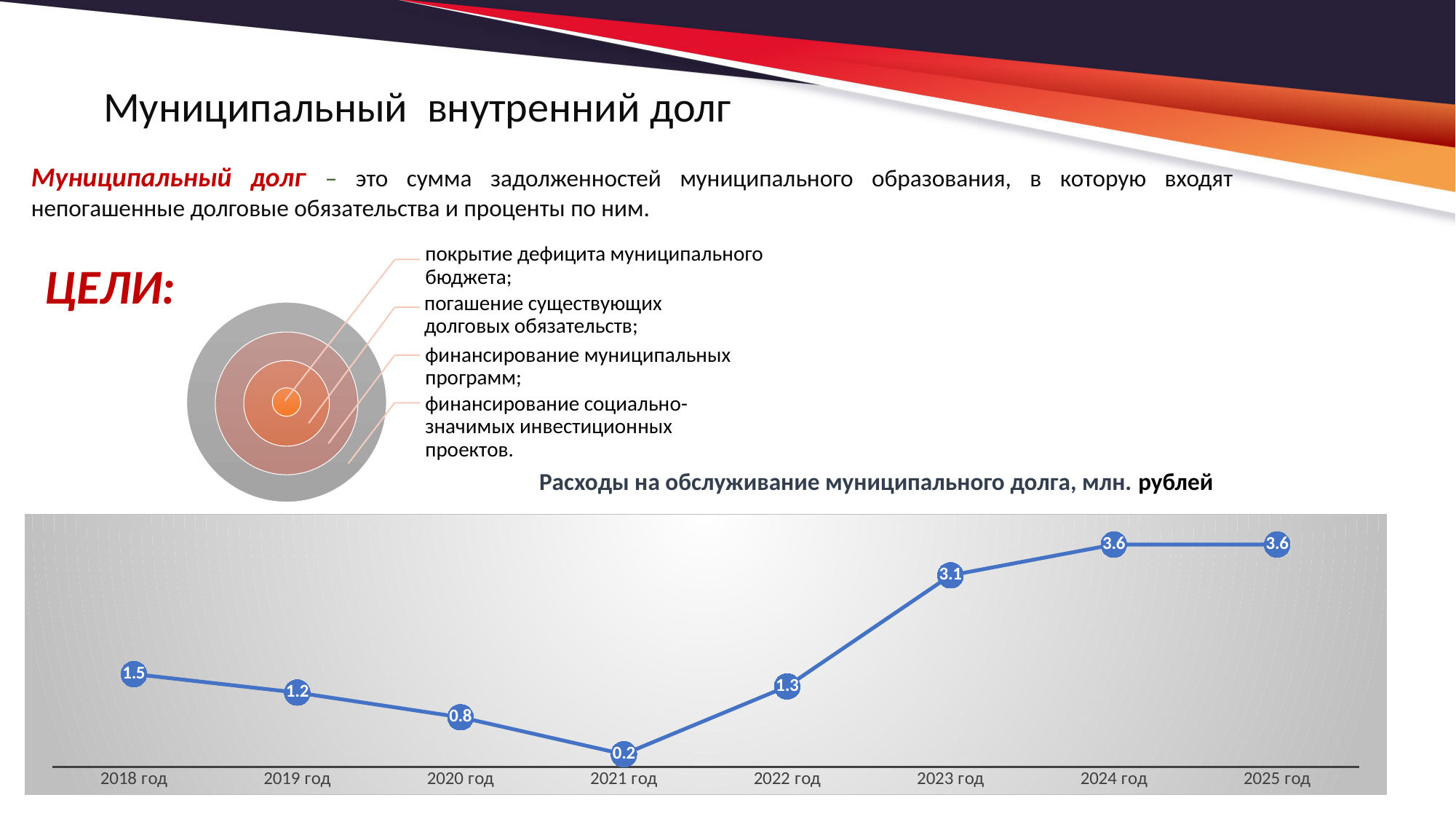
Do the values rise or fall from 2018 год to 2021 год? fall What is the value for 2018 год? 1.5 How many years are plotted on the chart? 8 Which year has the lowest value? 2021 год Which is larger, the value for 2019 год or the value for 2022 год? 2022 год What is the value for 2025 год? 3.6 What is the title of the chart? Расходы на обслуживание муниципального долга, млн. рублей What type of chart is shown on the slide? line chart What is the value for 2023 год? 3.1 What is the difference between the values for 2018 год and 2021 год? 1.3 What is the difference between the values for 2024 год and 2023 год? 0.5 What is the value for 2021 год? 0.2